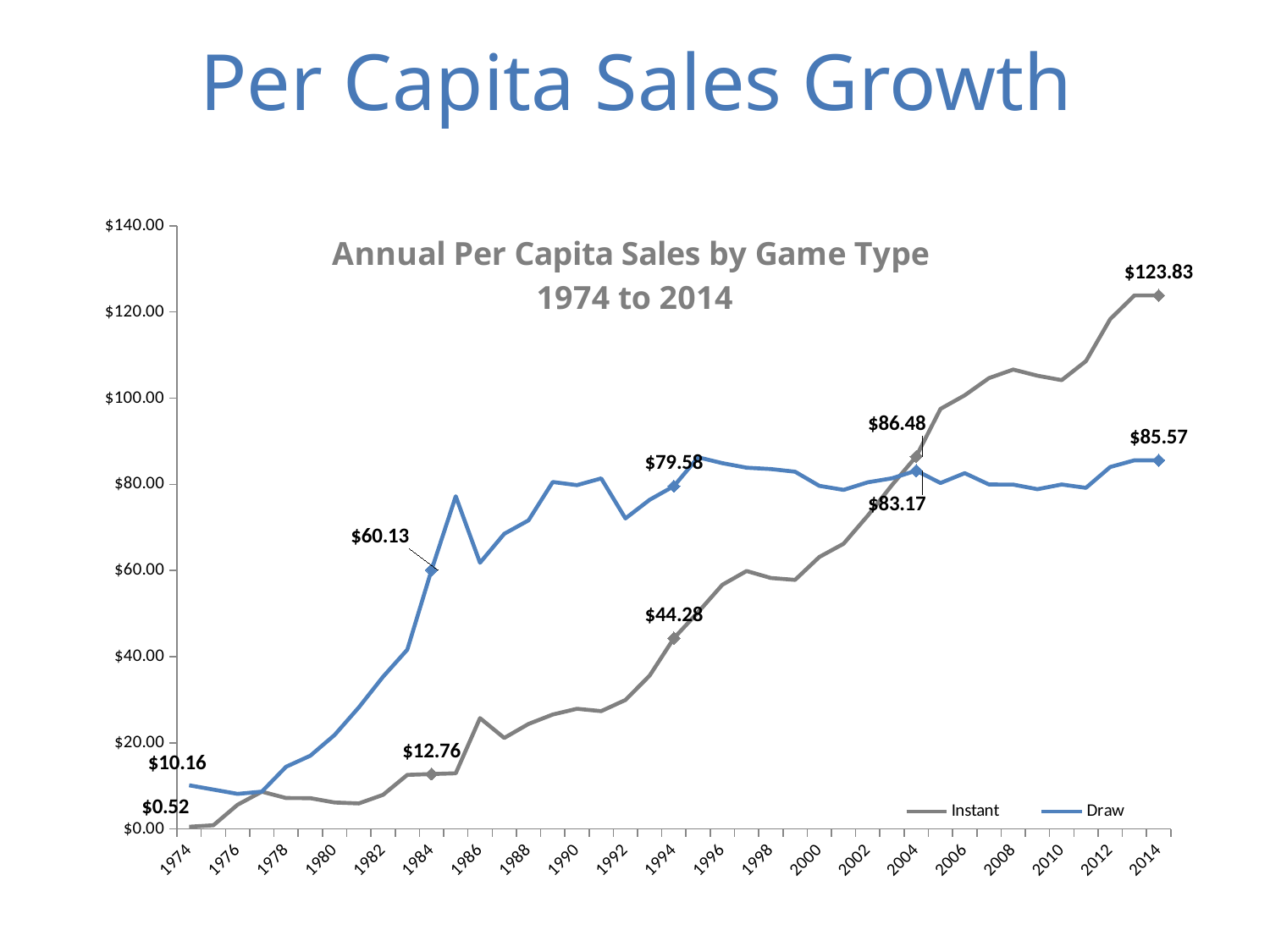
Does the Instant series generally rise or fall from 1974 to 2014? Rise Is the value for Instant in 2008 greater or less than $100.00? greater What is the difference between Draw and Instant in 1994? $35.30 What is the title of the chart? Annual Per Capita Sales by Game Type 1974 to 2014 What kind of chart is shown on the slide? Line chart What is the value for Draw in 2004? $83.17 What is the value for Instant in 2014? $123.83 Which series has the larger value in 1984, Instant or Draw? Draw What is the value for Draw in 1984? $60.13 How many series does the legend list? 2 What is the value for Instant in 1974? $0.52 What is the difference between Instant and Draw in 2014? $38.26